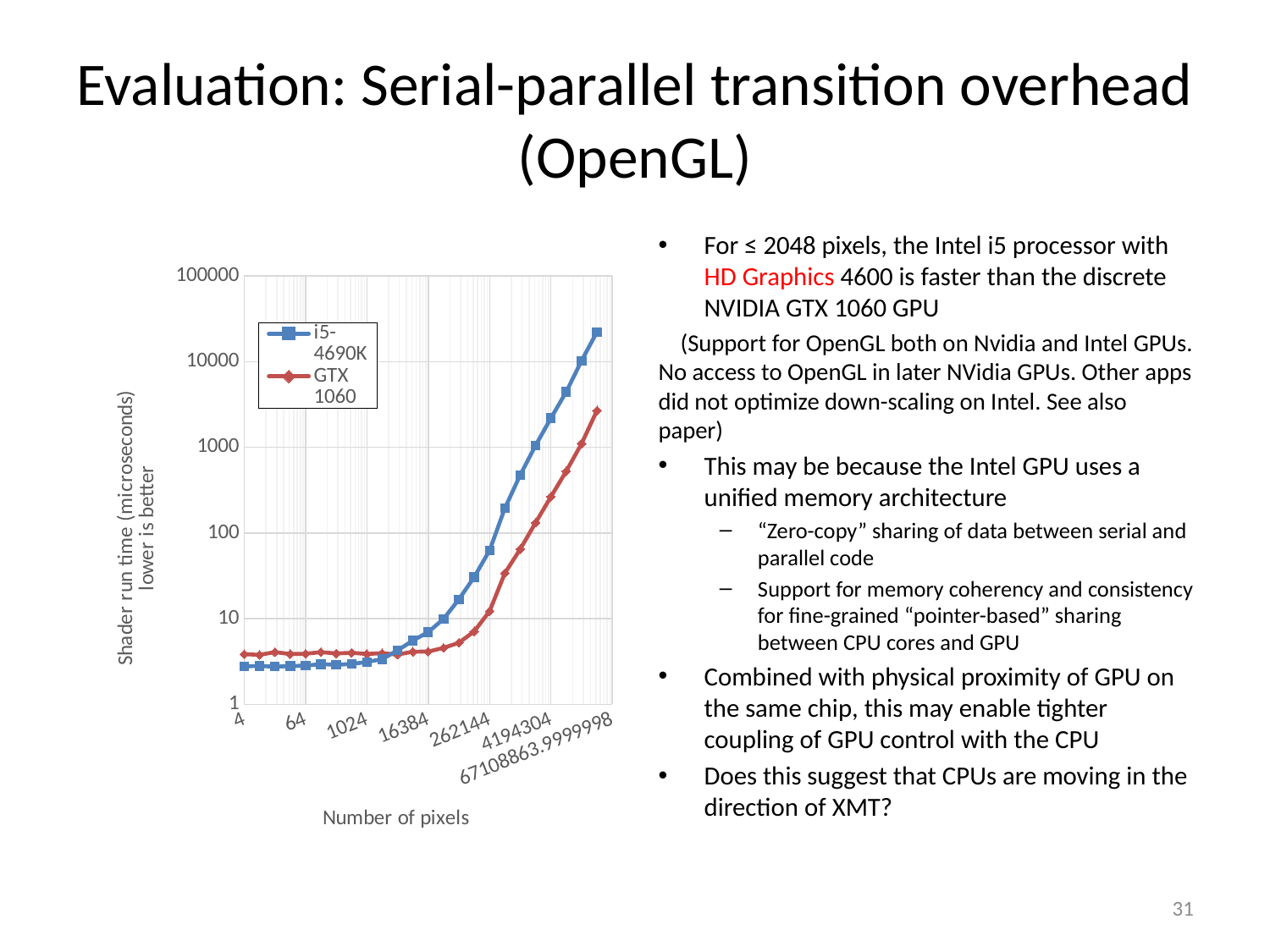
Is the GTX 1060 value at the rightmost point of the chart greater or less than 10000? less Is the i5-4690K value at the rightmost point of the chart greater or less than 10000? greater What are the two series named in the chart's legend? i5-4690K and GTX 1060 What is the title of the chart's x axis? Number of pixels Which series reaches the highest shader run time anywhere on the chart? i5-4690K How many series does the chart's legend list? 2 At 4 pixels, which series has the higher shader run time, i5-4690K or GTX 1060? GTX 1060 What kind of chart is shown on the slide? line chart Is the i5-4690K value at 4 pixels greater or less than 10? less Do the i5-4690K values rise or fall overall as the number of pixels increases? rise At the largest number of pixels on the x axis, which series has the higher shader run time, i5-4690K or GTX 1060? i5-4690K